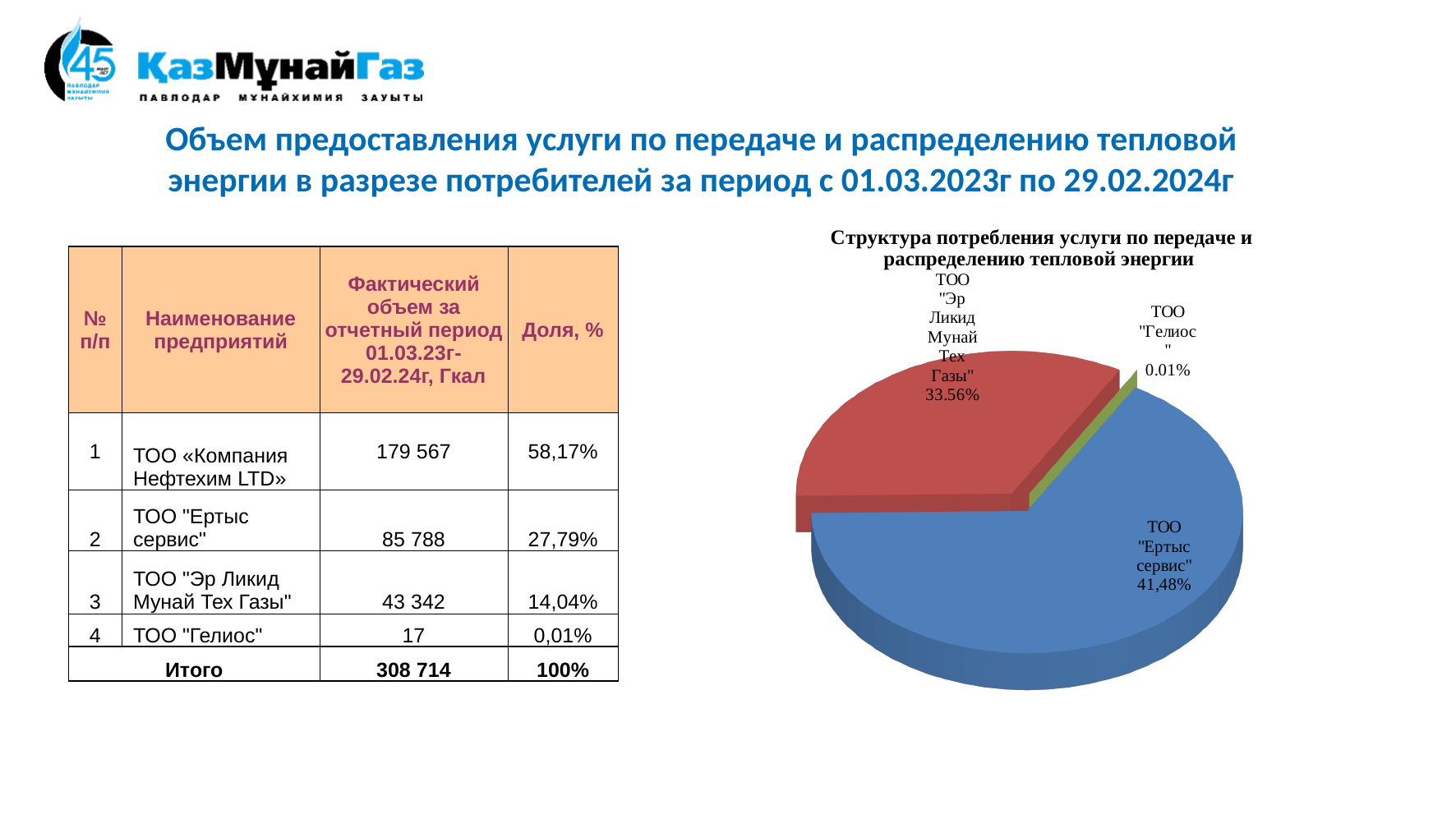
How many slices are labelled in the pie chart? 3 What share does the pie chart show for ТОО "Ертыс сервис"? 41,48% What is the title of the pie chart? Структура потребления услуги по передаче и распределению тепловой энергии Which slice of the pie chart is the smallest? ТОО "Гелиос" What share does the pie chart show for ТОО "Гелиос"? 0.01% What share does the pie chart show for ТОО "Эр Ликид Мунай Тех Газы"? 33.56% What colour is the slice for ТОО "Ертыс сервис" in the pie chart? blue In the pie chart, which is larger: the share for ТОО "Ертыс сервис" or for ТОО "Эр Ликид Мунай Тех Газы"? ТОО "Ертыс сервис" Which slice of the pie chart is the largest? ТОО "Ертыс сервис" What kind of chart is shown on the slide? pie chart